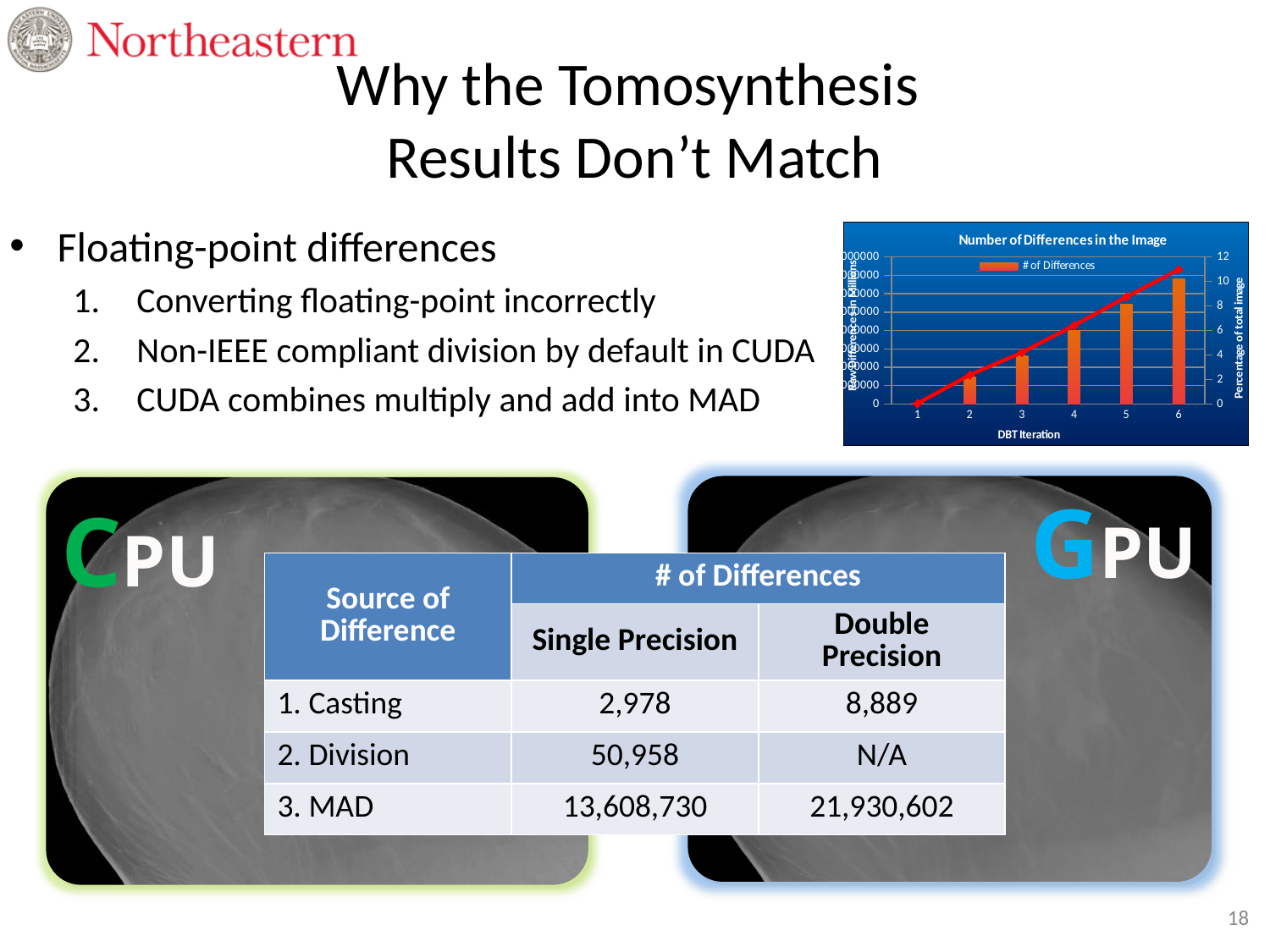
Do the number of differences rise or fall as the DBT iteration increases? rise How many DBT iterations are shown on the x axis of the chart? 6 How many series does the chart's legend list? 1 Which DBT iteration has the highest number of differences in the chart? 6 What is the title of the chart on the slide? Number of Differences in the Image What kind of chart is shown on the slide? combination bar and line chart What is the title of the x axis of the chart? DBT Iteration Which DBT iteration has the lowest number of differences in the chart? 1 Which has more differences in the chart, DBT iteration 2 or DBT iteration 4? 4 Which has more differences in the chart, DBT iteration 3 or DBT iteration 5? 5